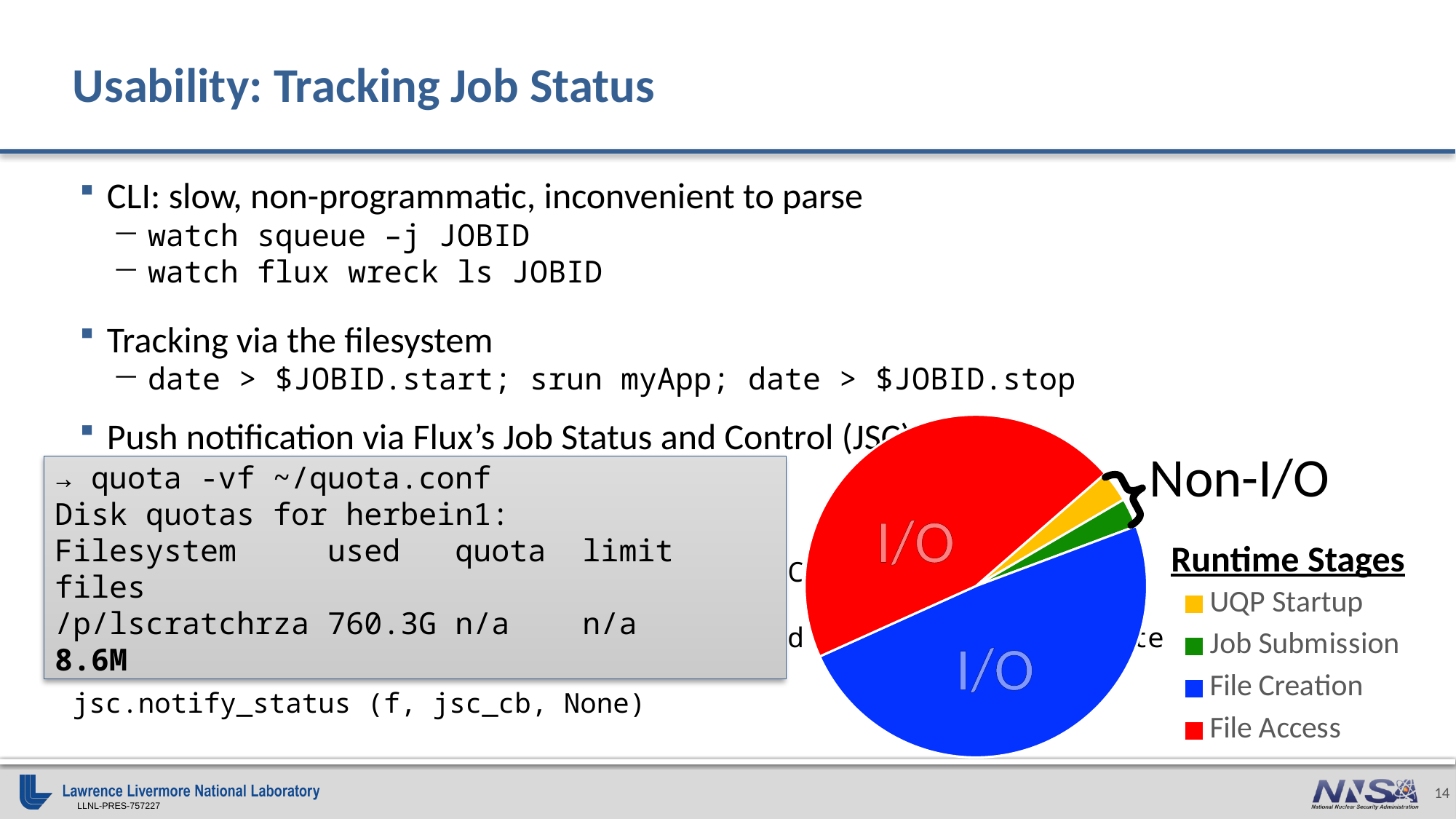
Which slice is larger in the pie chart, File Creation or UQP Startup? File Creation Which colour represents File Access in the pie chart? red How many entries does the legend of the pie chart list? 4 What kind of chart is shown on the slide? pie chart Which slice is larger in the pie chart, File Access or Job Submission? File Access Which slice is larger in the pie chart, File Creation or Job Submission? File Creation What is the title of the pie chart's legend? Runtime Stages How many slices does the pie chart have? 4